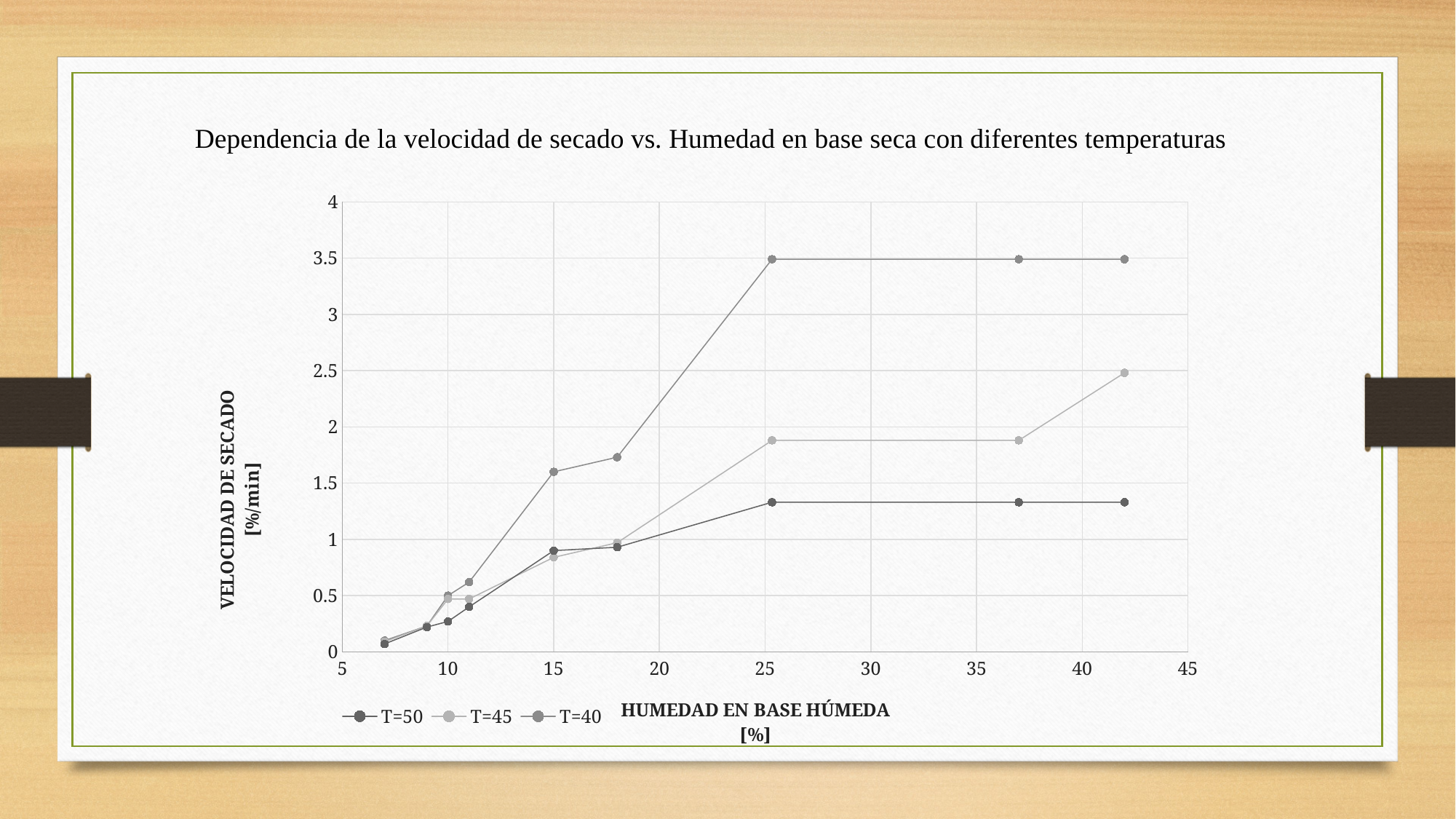
What is the title of the chart? Dependencia de la velocidad de secado vs. Humedad en base seca con diferentes temperaturas Is the value for T=50 at a humidity of about 37% greater or less than 1.5? less How many series does the legend list? 3 Does the T=40 series rise or fall as humidity increases from 5% to 25%? rise What kind of chart is shown on the slide? line chart Does the T=50 series rise, fall or stay flat between humidity of about 25% and 42%? stay flat At a humidity of about 25%, which series has the higher value, T=40 or T=50? T=40 Is the value for T=45 at a humidity of about 42% greater or less than 2? greater What are the series names listed in the legend? T=50, T=45, T=40 Which series reaches the highest drying velocity on the chart? T=40 Is the value for T=45 at a humidity of about 25% greater or less than 1.5? greater